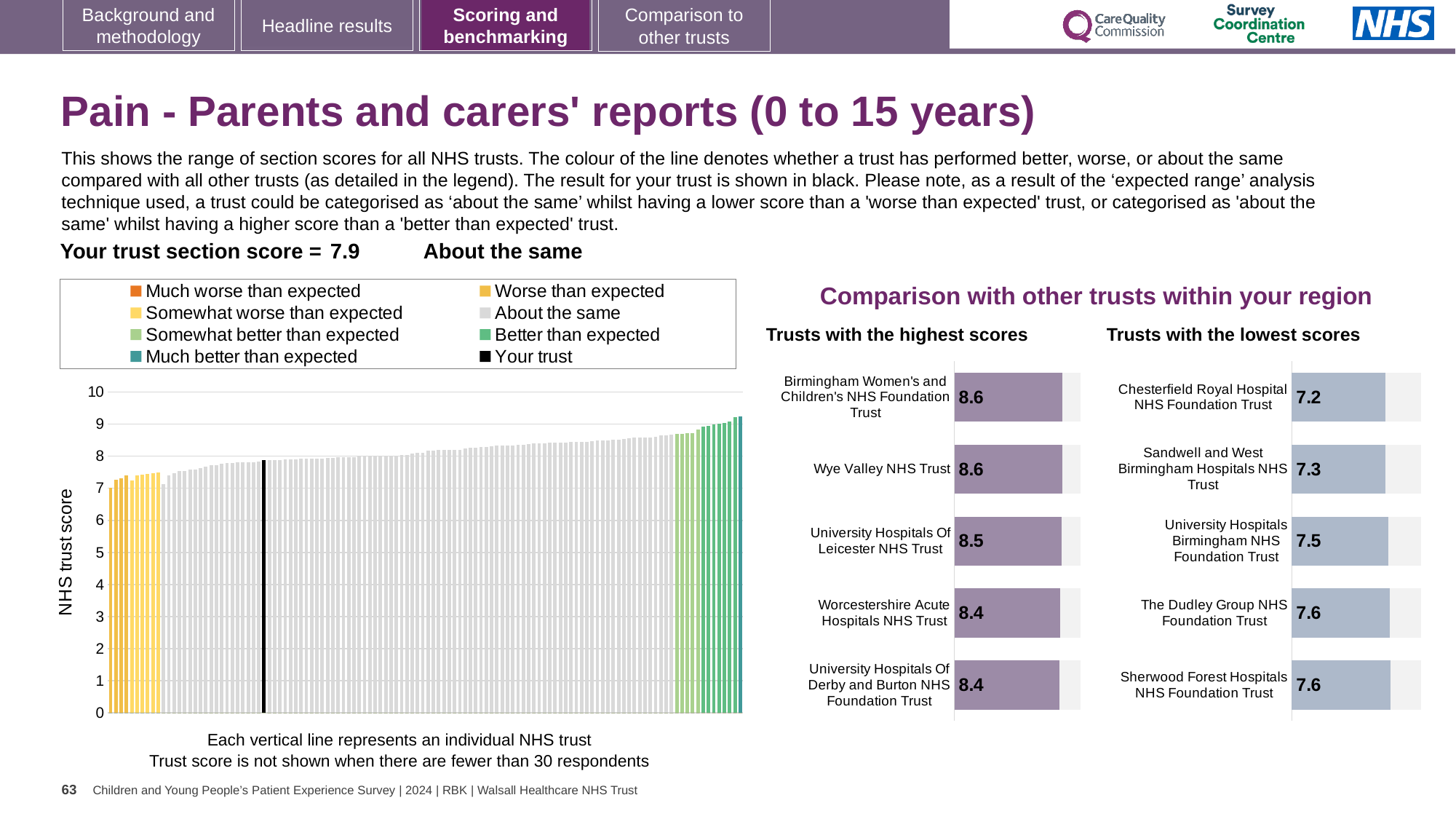
In the 'Trusts with the lowest scores' chart, which trust has the lowest score? Chesterfield Royal Hospital NHS Foundation Trust In the 'NHS trust score' chart on the left, do the bar heights rise or fall from left to right? Rise How many trusts are shown in the 'Trusts with the highest scores' chart? 5 How many entries does the legend of the 'NHS trust score' chart on the left list? 8 In the 'Trusts with the lowest scores' chart, what is the difference between the score for Sherwood Forest Hospitals NHS Foundation Trust and the score for Chesterfield Royal Hospital NHS Foundation Trust? 0.4 In the 'Trusts with the lowest scores' chart, which has the higher score: Sandwell and West Birmingham Hospitals NHS Trust or University Hospitals Birmingham NHS Foundation Trust? University Hospitals Birmingham NHS Foundation Trust In the 'Trusts with the highest scores' chart, what is the score for Wye Valley NHS Trust? 8.6 In the 'Trusts with the lowest scores' chart, what is the score for The Dudley Group NHS Foundation Trust? 7.6 What type of chart is the 'NHS trust score' chart on the left of the slide? Bar chart In the 'Trusts with the highest scores' chart, what is the score for University Hospitals Of Leicester NHS Trust? 8.5 In the 'Trusts with the lowest scores' chart, what is the score for Chesterfield Royal Hospital NHS Foundation Trust? 7.2 In the 'Trusts with the highest scores' chart, what is the difference between the score for Birmingham Women's and Children's NHS Foundation Trust and the score for Worcestershire Acute Hospitals NHS Trust? 0.2